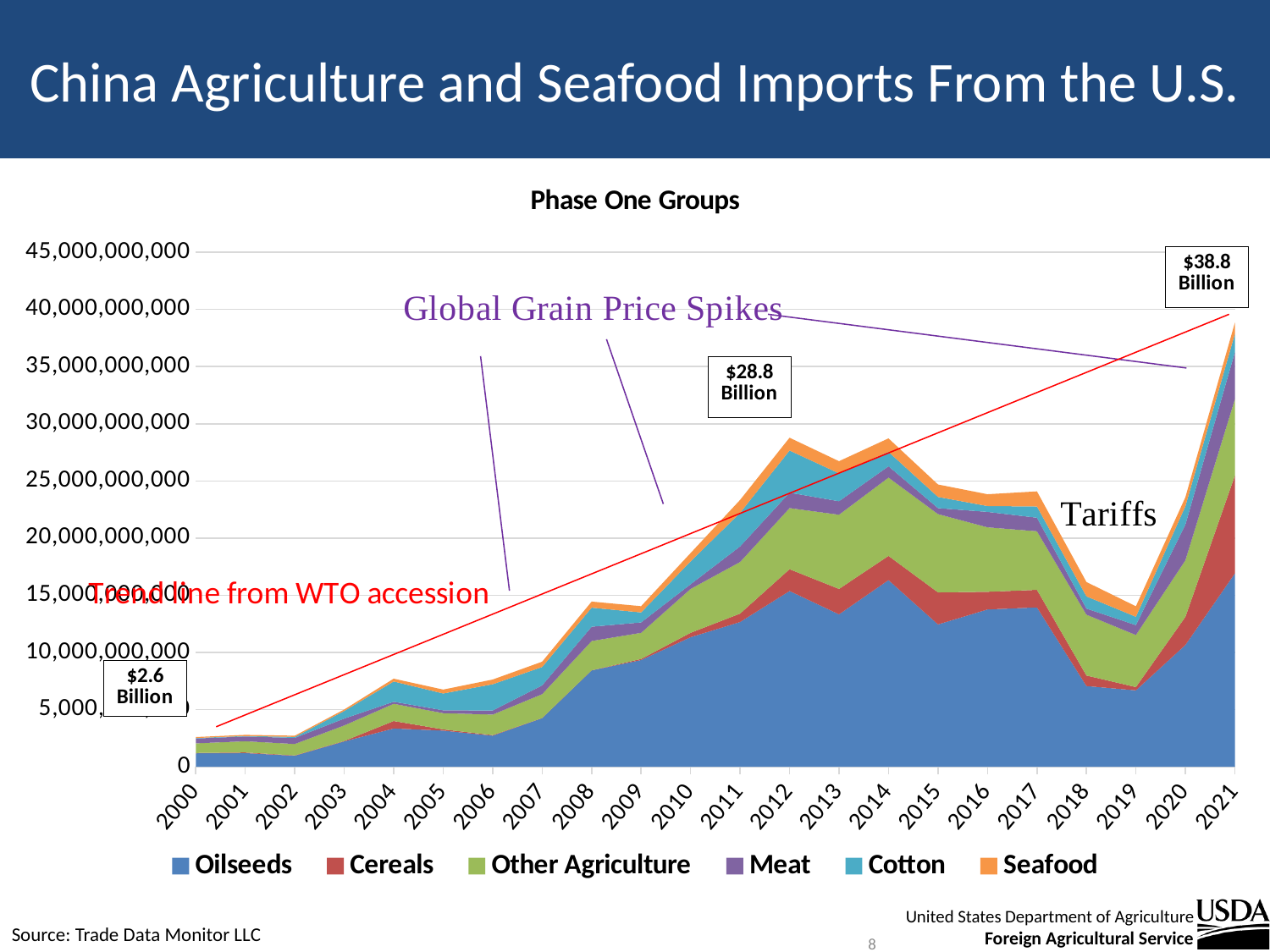
Do the total imports rise or fall from 2017 to 2018? fall How many years are shown along the x axis of the chart? 22 What is the title of the chart? Phase One Groups Is the total value for 2018 greater or less than 20,000,000,000? less What is the difference between the labelled totals for 2021 and 2012? $10 Billion How many series does the legend of the chart list? 6 Is the total value for 2014 greater or less than 25,000,000,000? greater What type of chart is shown on the slide? Stacked area chart What total value is labelled on the chart for 2000? $2.6 Billion What total value is labelled on the chart for 2012? $28.8 Billion What total value is labelled on the chart for 2021? $38.8 Billion Which year has the highest total imports in the chart? 2021